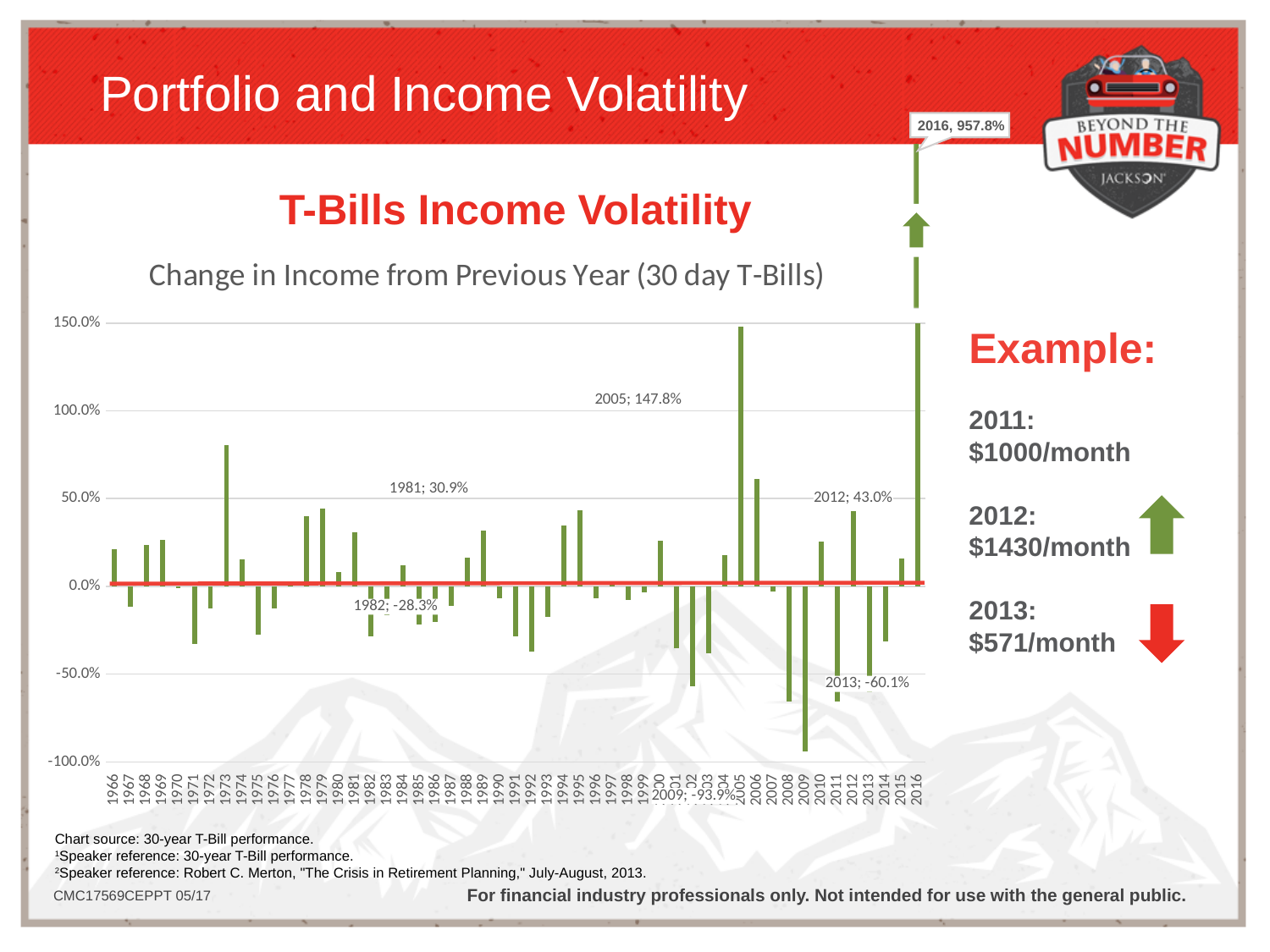
What kind of chart is shown on the slide? bar chart Which year has the lowest value in the chart? 2009 What is the value for 2013 in the chart? -60.1% What is the difference between the values for 2012 and 2013? 103.1 percentage points What is the value for 1982 in the chart? -28.3% Is the value for 1973 greater or less than 50.0%? greater Is the value for 2008 greater or less than -50.0%? less What is the title of the chart? Change in Income from Previous Year (30 day T-Bills) What is the value for 2016 in the chart? 957.8% Which year has the highest value in the chart? 2016 Which is larger, the value for 2005 or the value for 2012? 2005 What is the value for 2005 in the chart? 147.8%